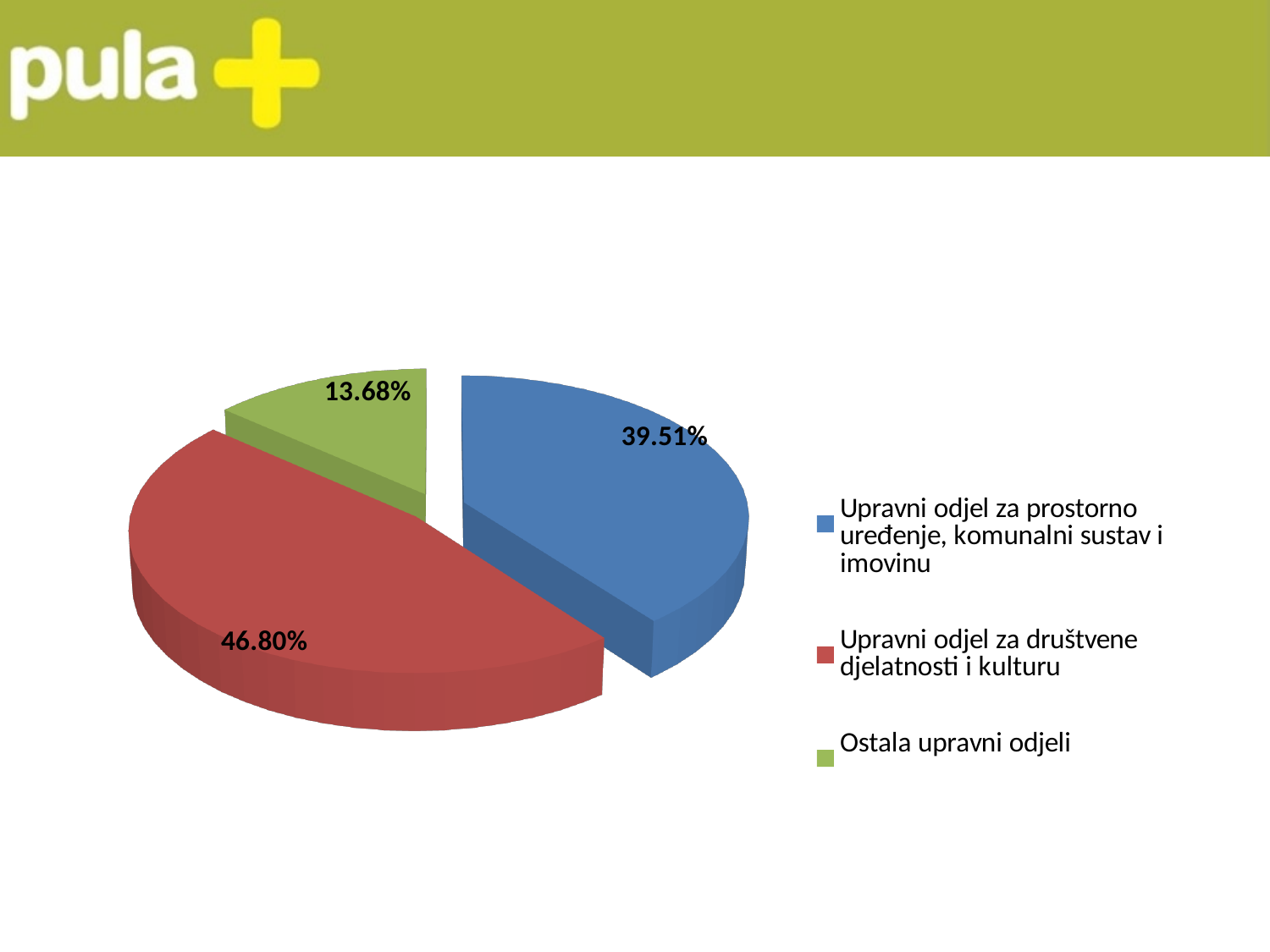
What is the difference in percentage points between the slice for "Upravni odjel za društvene djelatnosti i kulturu" and the slice for "Upravni odjel za prostorno uređenje, komunalni sustav i imovinu"? 7.29 How many slices does the pie chart have? 3 What share of the pie does "Ostala upravni odjeli" have? 13.68% How many entries does the legend list? 3 What colour is the slice for "Ostala upravni odjeli"? green What share of the pie does "Upravni odjel za prostorno uređenje, komunalni sustav i imovinu" have? 39.51% What colour is the slice for "Upravni odjel za društvene djelatnosti i kulturu"? red What kind of chart is shown on the slide? pie chart Which category has the smallest slice of the pie? Ostala upravni odjeli Which category has the largest slice of the pie? Upravni odjel za društvene djelatnosti i kulturu What share of the pie does "Upravni odjel za društvene djelatnosti i kulturu" have? 46.80% Which is larger: the slice for "Upravni odjel za prostorno uređenje, komunalni sustav i imovinu" or the slice for "Ostala upravni odjeli"? Upravni odjel za prostorno uređenje, komunalni sustav i imovinu